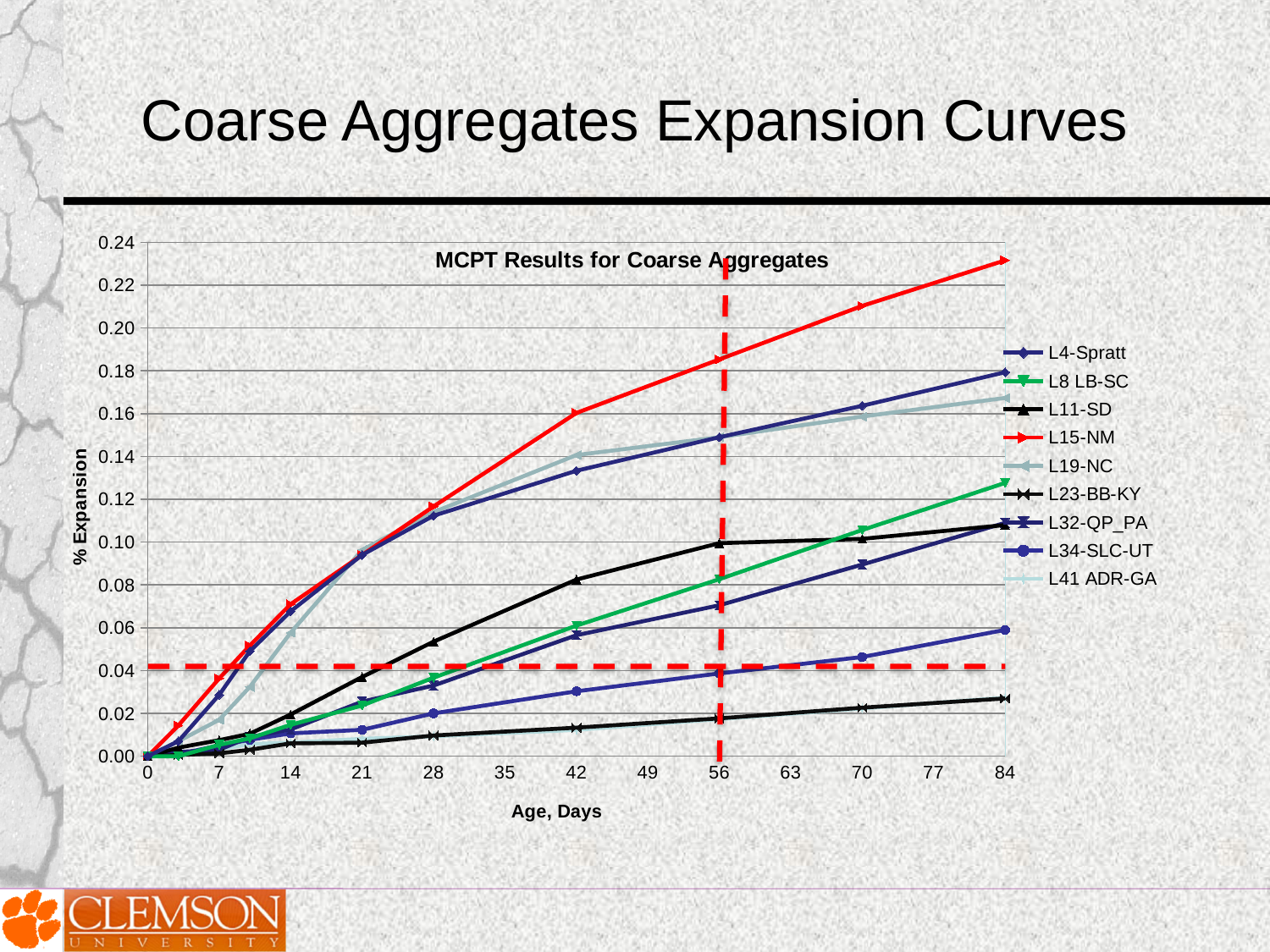
What kind of chart is shown on the slide? line chart Does the % Expansion for L15-NM rise or fall as Age increases? rise Is the value for L15-NM at 56 days greater or less than 0.18? greater How many series does the legend list? 9 At 84 days, which series has the larger % Expansion, L8 LB-SC or L11-SD? L8 LB-SC What is the title of the chart? MCPT Results for Coarse Aggregates Is the value for L15-NM at 84 days greater or less than 0.22? greater At 84 days, which series has the larger % Expansion, L15-NM or L4-Spratt? L15-NM Is the value for L34-SLC-UT at 84 days greater or less than 0.04? greater Which series has the highest % Expansion at 84 days? L15-NM